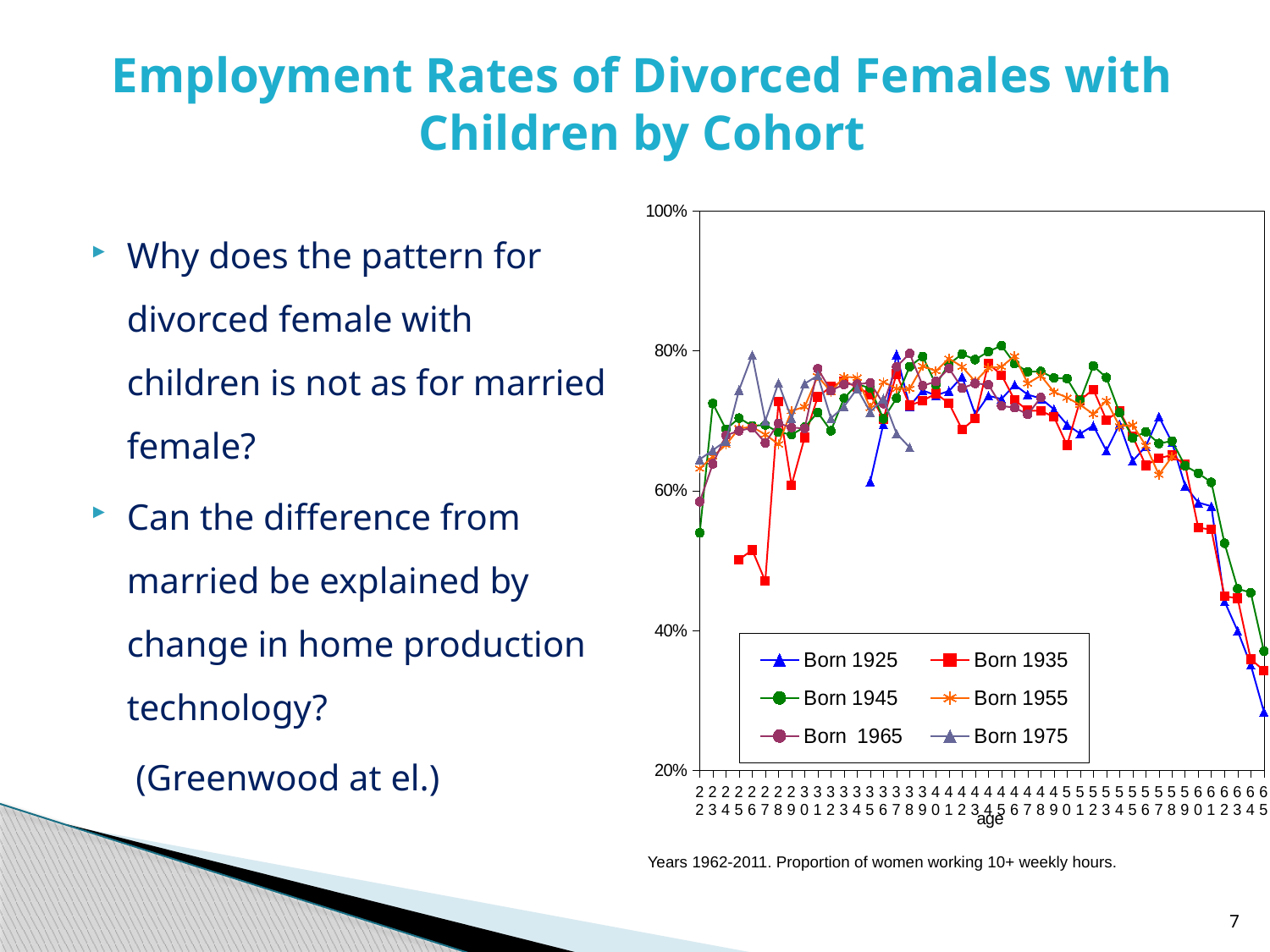
Is the value for Born 1925 at age 65 greater or less than 40%? less What kind of chart is shown on the slide? line chart How many series does the legend list? 6 Is the value for Born 1975 at age 27 greater or less than 60%? greater Is the value for Born 1935 at age 27 greater or less than 60%? less At age 27, which is larger: the value for Born 1935 or the value for Born 1975? Born 1975 Which cohorts are listed in the chart legend? Born 1925, Born 1935, Born 1945, Born 1955, Born 1965, Born 1975 At age 22, which series has the lowest value? Born 1945 What is the label of the x axis? age At age 65, which series has the lowest value? Born 1925 Does the Born 1925 series rise or fall between age 55 and age 65? fall